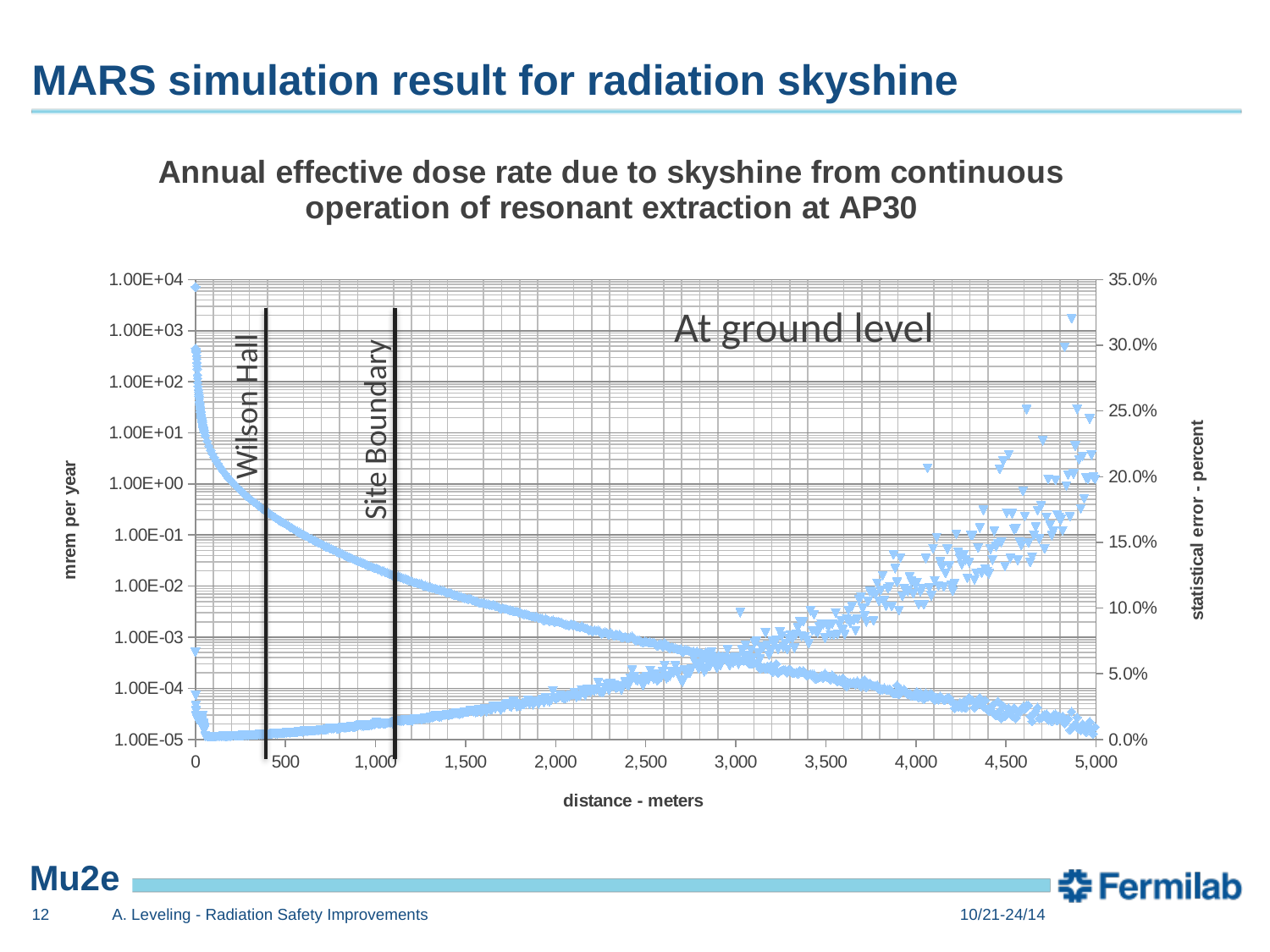
Is the statistical error at a distance of 1,000 meters greater or less than 5.0%? less Is the dose rate at a distance of 2,000 meters greater or less than 1.00E-02 mrem per year? less Is the statistical error at a distance of 4,000 meters greater or less than 5.0%? greater Does the dose rate (mrem per year) rise or fall as distance increases? fall Which is larger: the dose rate at 500 meters or the dose rate at 3,000 meters? 500 meters What kind of chart is shown on the slide? scatter chart Does the statistical error (percent) rise or fall as distance increases? rise What is the label of the x axis? distance - meters What is the title of the chart? Annual effective dose rate due to skyshine from continuous operation of resonant extraction at AP30